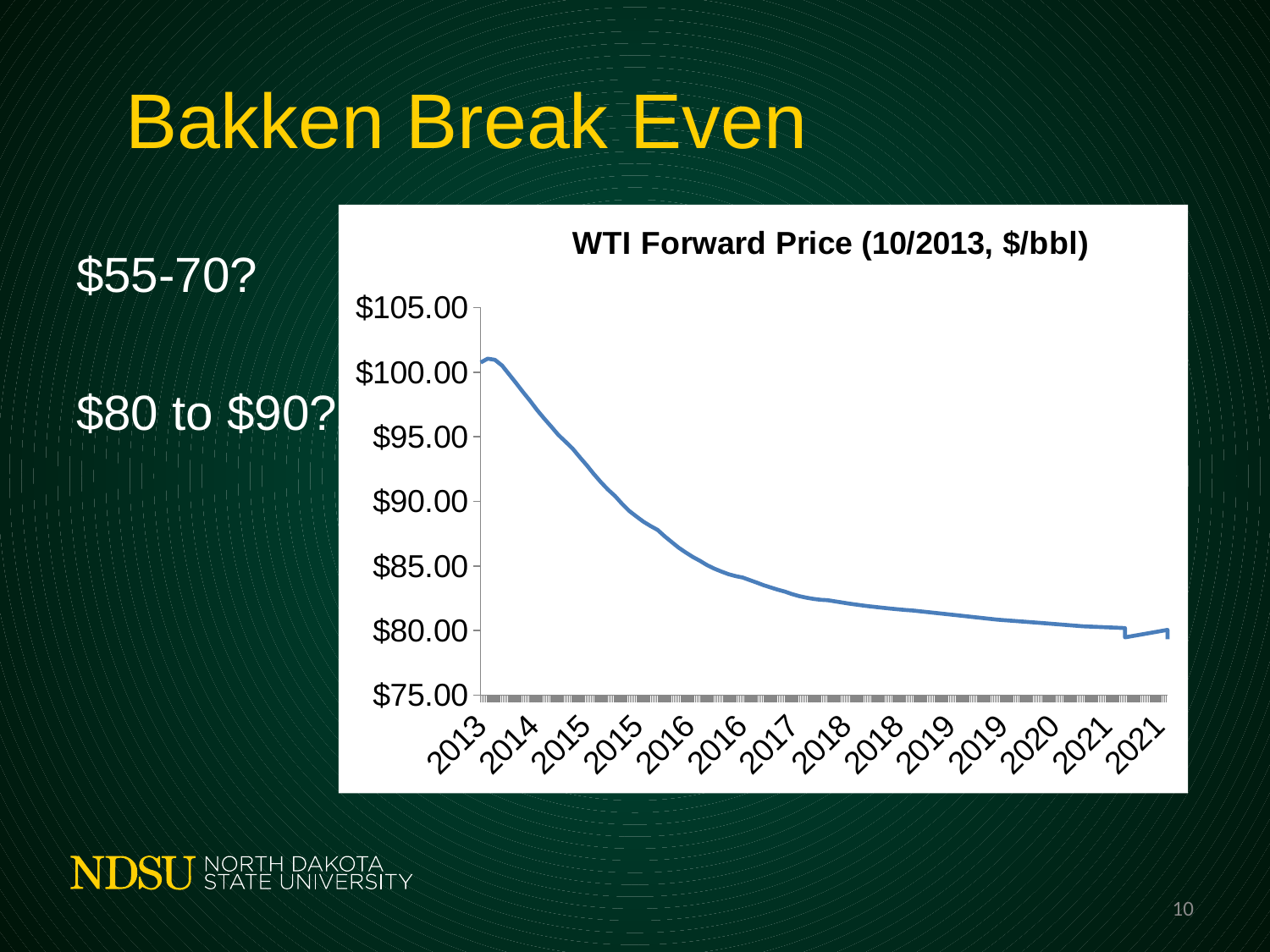
Is the value at the first 2018 label greater or less than $85.00? less Do the values in the chart rise or fall from 2013 to 2021? fall Is the value at the 2020 label greater or less than $85.00? less Is the value at the first 2016 label greater or less than $90.00? less What is the title of the chart? WTI Forward Price (10/2013, $/bbl) At which year label is the forward price highest? 2013 Is the value at 2013 larger or smaller than the value at 2021? larger What kind of chart is shown on the slide? line chart What is the lowest value shown on the y axis? $75.00